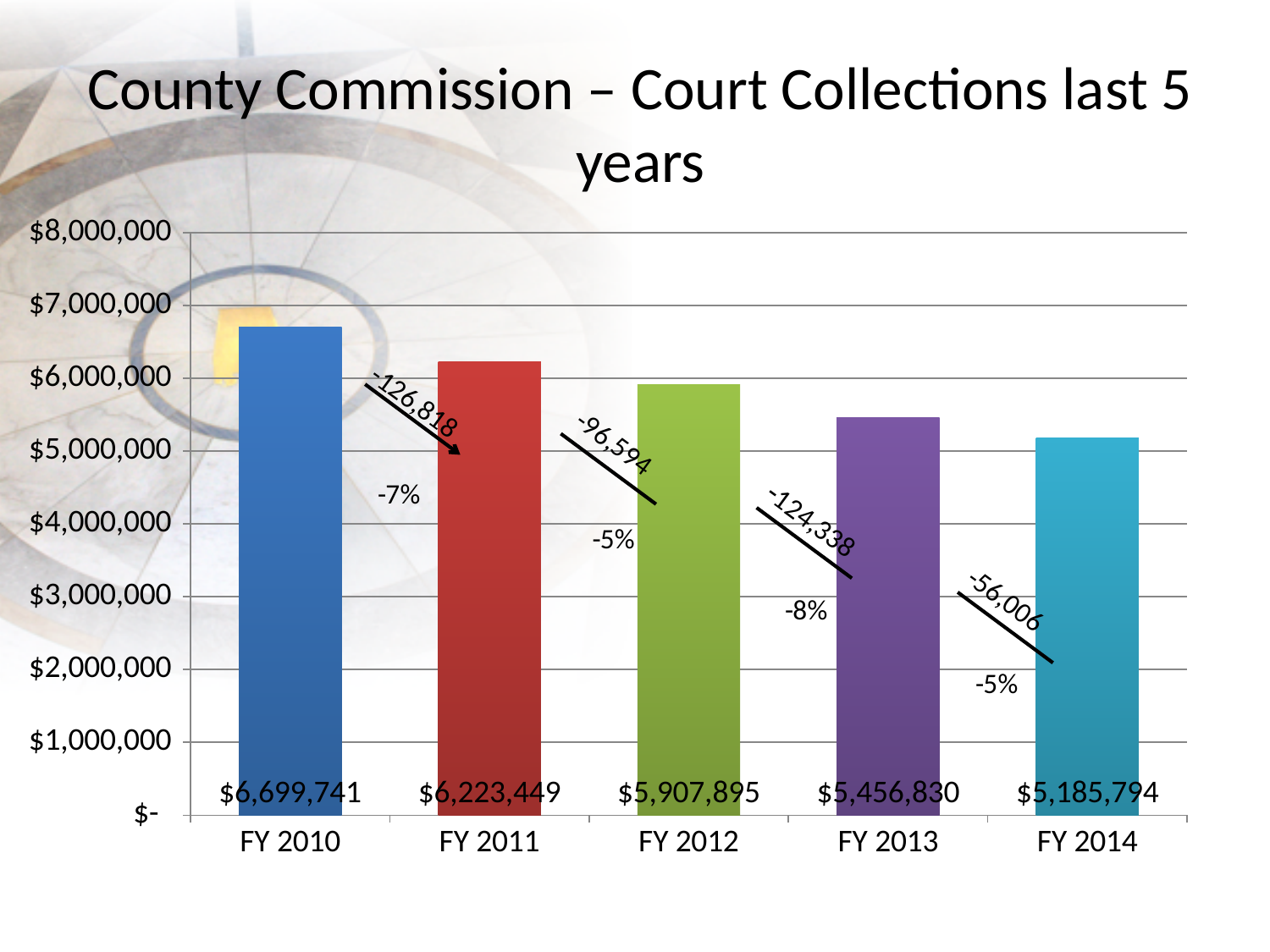
Which is larger, the value for FY 2011 or the value for FY 2013? FY 2011 What is the value for FY 2013? $5,456,830 How many fiscal years are shown in the chart? 5 What is the value for FY 2014? $5,185,794 What is the value for FY 2012? $5,907,895 Is the value for FY 2012 greater or less than $6,000,000? less Do the values rise or fall from FY 2010 to FY 2014? fall What is the value for FY 2010? $6,699,741 What percentage change is annotated between FY 2012 and FY 2013? -8% Which fiscal year has the lowest court collections? FY 2014 What kind of chart is shown on the slide? bar chart Which fiscal year has the highest court collections? FY 2010